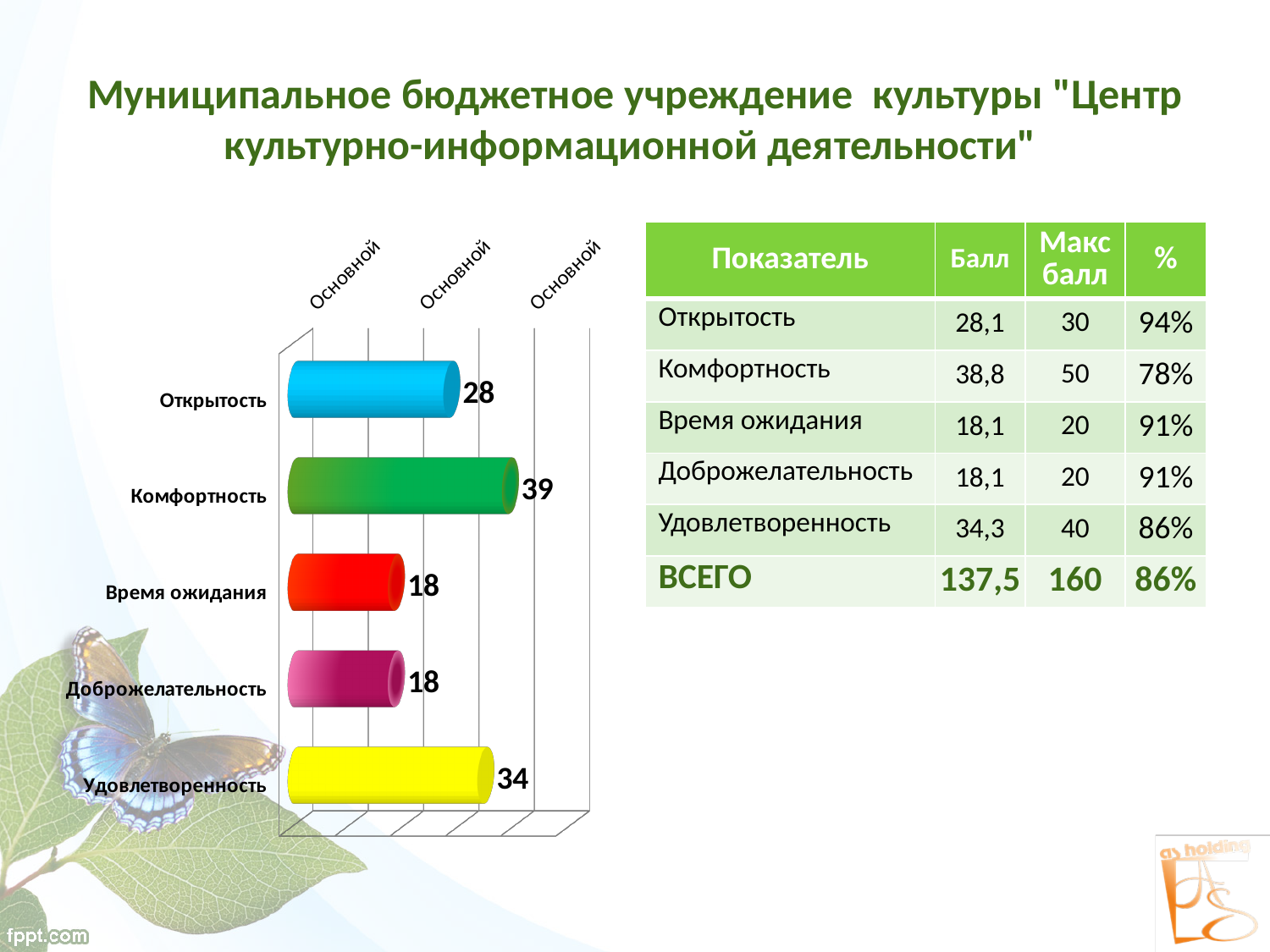
Which is larger in the bar chart, the value for Комфортность or the value for Удовлетворенность? Комфортность What is the value shown for Открытость in the bar chart? 28 What is the value shown for Время ожидания in the bar chart? 18 What is the difference between the values for Удовлетворенность and Доброжелательность in the bar chart? 16 How many categories are shown in the bar chart? 5 What is the value shown for Удовлетворенность in the bar chart? 34 What kind of chart is shown on the slide? Bar chart Which category has the highest value in the bar chart? Комфортность What colour is the bar for Удовлетворенность in the chart? Yellow What is the value shown for Комфортность in the bar chart? 39 What is the difference between the values for Комфортность and Открытость in the bar chart? 11 Which is larger in the bar chart, the value for Открытость or the value for Удовлетворенность? Удовлетворенность